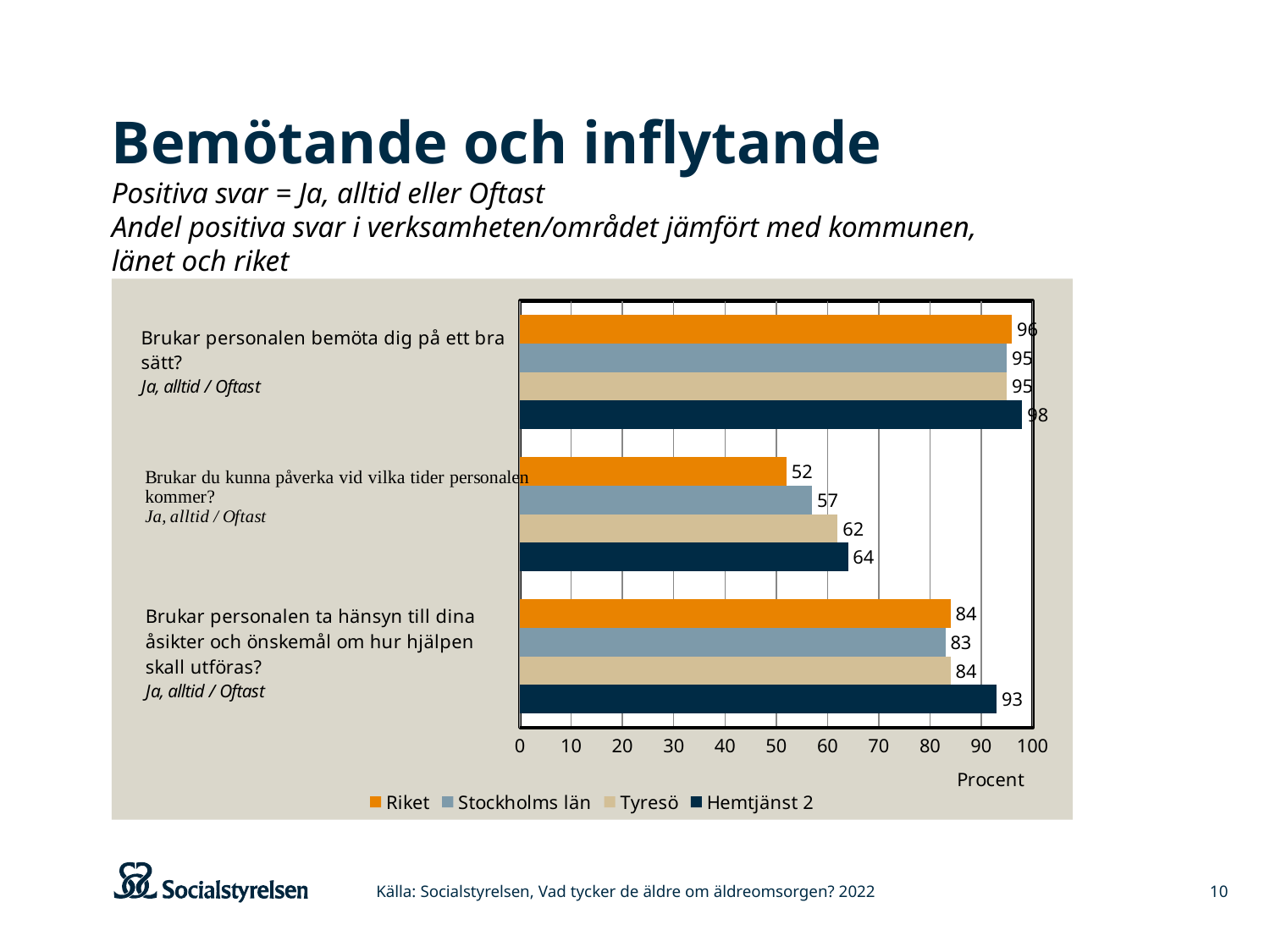
How many question categories are plotted on the chart? 3 Which is larger for the question "Brukar personalen ta hänsyn till dina åsikter och önskemål om hur hjälpen skall utföras?": Hemtjänst 2 or Stockholms län? Hemtjänst 2 What is the difference between Hemtjänst 2 and Stockholms län for the question "Brukar personalen bemöta dig på ett bra sätt?"? 3 What label is shown on the horizontal axis of the chart? Procent What is the value for Hemtjänst 2 for the question "Brukar personalen bemöta dig på ett bra sätt?"? 98 What is the value for Riket for the question "Brukar du kunna påverka vid vilka tider personalen kommer?"? 52 What kind of chart is shown on the slide? Bar chart What is the value for Tyresö for the question "Brukar personalen ta hänsyn till dina åsikter och önskemål om hur hjälpen skall utföras?"? 84 Which series has the lowest value for the question "Brukar du kunna påverka vid vilka tider personalen kommer?"? Riket What is the difference between Hemtjänst 2 and Riket for the question "Brukar du kunna påverka vid vilka tider personalen kommer?"? 12 How many series does the legend list? 4 Which series has the highest value for the question "Brukar personalen ta hänsyn till dina åsikter och önskemål om hur hjälpen skall utföras?"? Hemtjänst 2